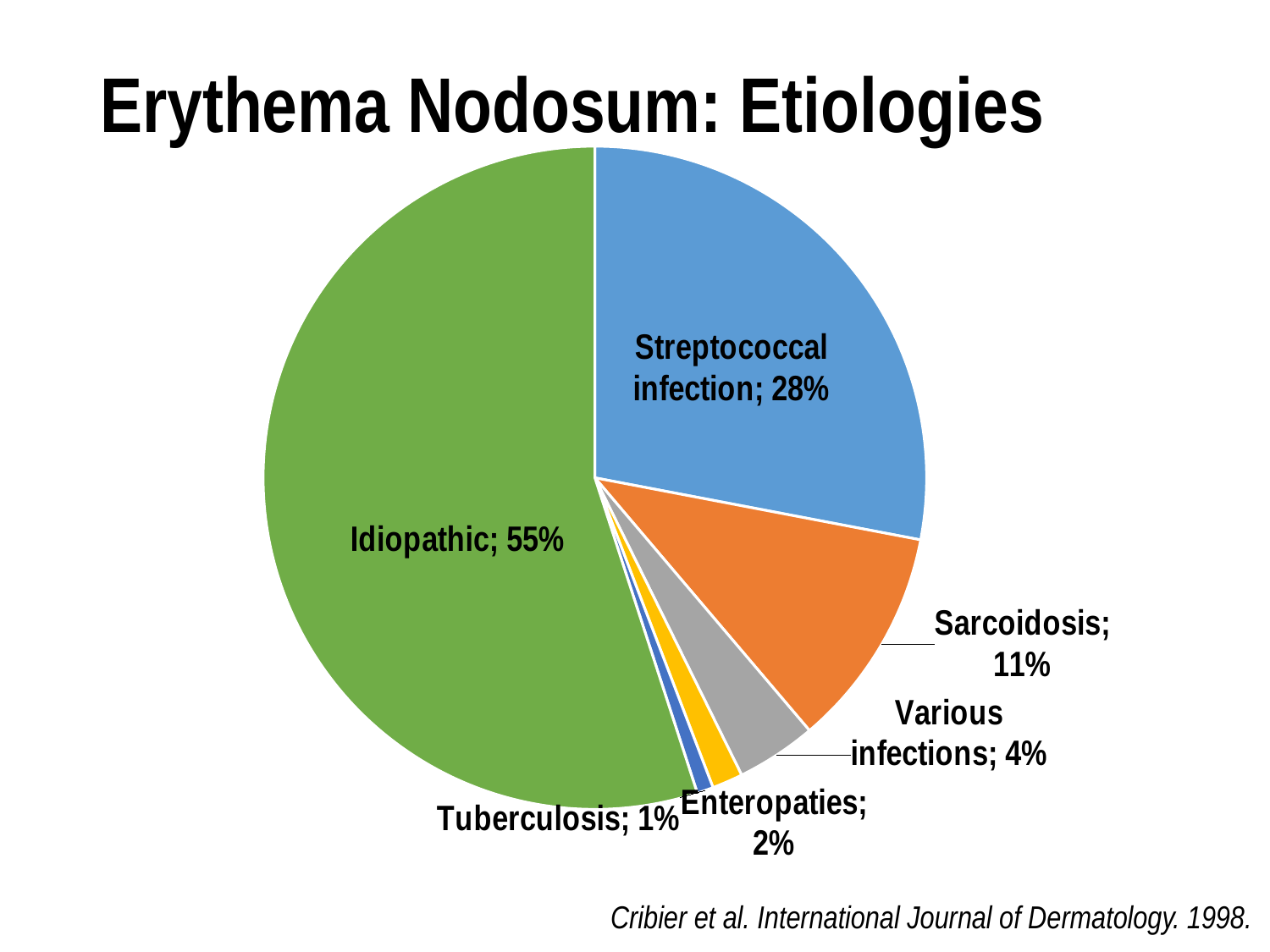
What is the title of the slide containing the chart? Erythema Nodosum: Etiologies How many etiology categories are shown in the pie chart? 6 Which is larger, the share for Sarcoidosis or the share for Various infections? Sarcoidosis What is the value for Various infections? 4% What type of chart is shown on the slide? Pie chart Which etiology has the largest share of the pie? Idiopathic What is the value shown for Streptococcal infection? 28% What percentage is shown for Enteropaties? 2% What percentage is shown for Sarcoidosis? 11% What percentage of erythema nodosum cases are attributed to Idiopathic causes? 55% What is the difference in percentage points between Idiopathic and Streptococcal infection? 27% Which etiology has the smallest share of the pie? Tuberculosis